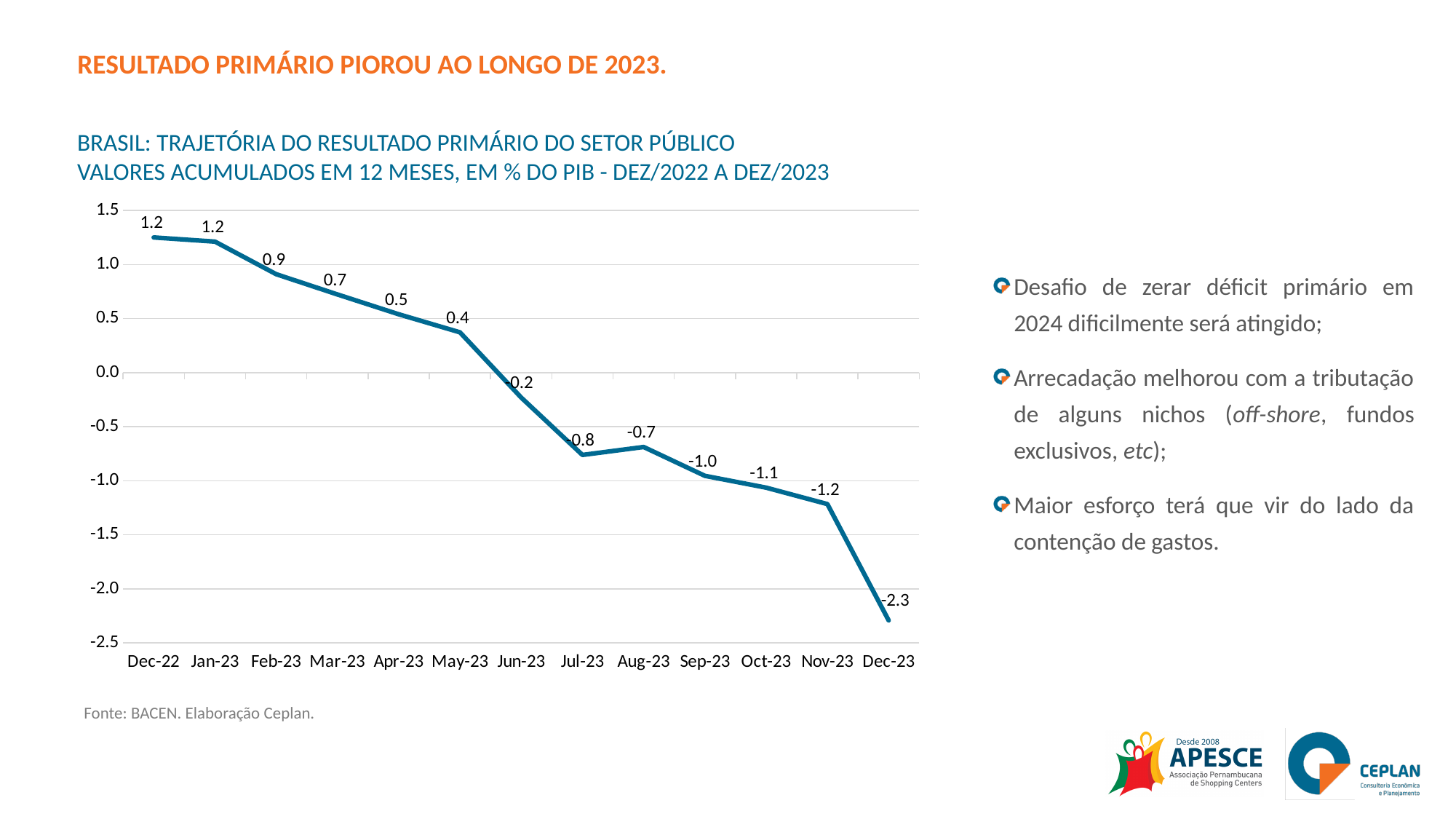
Which month has the lowest value? Dec-23 What is the difference between the values for Feb-23 and Mar-23? 0.2 What is the value for Dec-23? -2.3 Do the values rise or fall from Dec-22 to Dec-23? fall What is the difference between the values for Dec-22 and Dec-23? 3.5 What kind of chart is shown on the slide? line chart How many months are plotted on the chart? 13 Which is larger, the value for Jul-23 or the value for Aug-23? Aug-23 What is the source cited below the chart? BACEN. Elaboração Ceplan. Is the value for Nov-23 greater or less than -1.0? less What is the value for May-23? 0.4 What is the value for Aug-23? -0.7